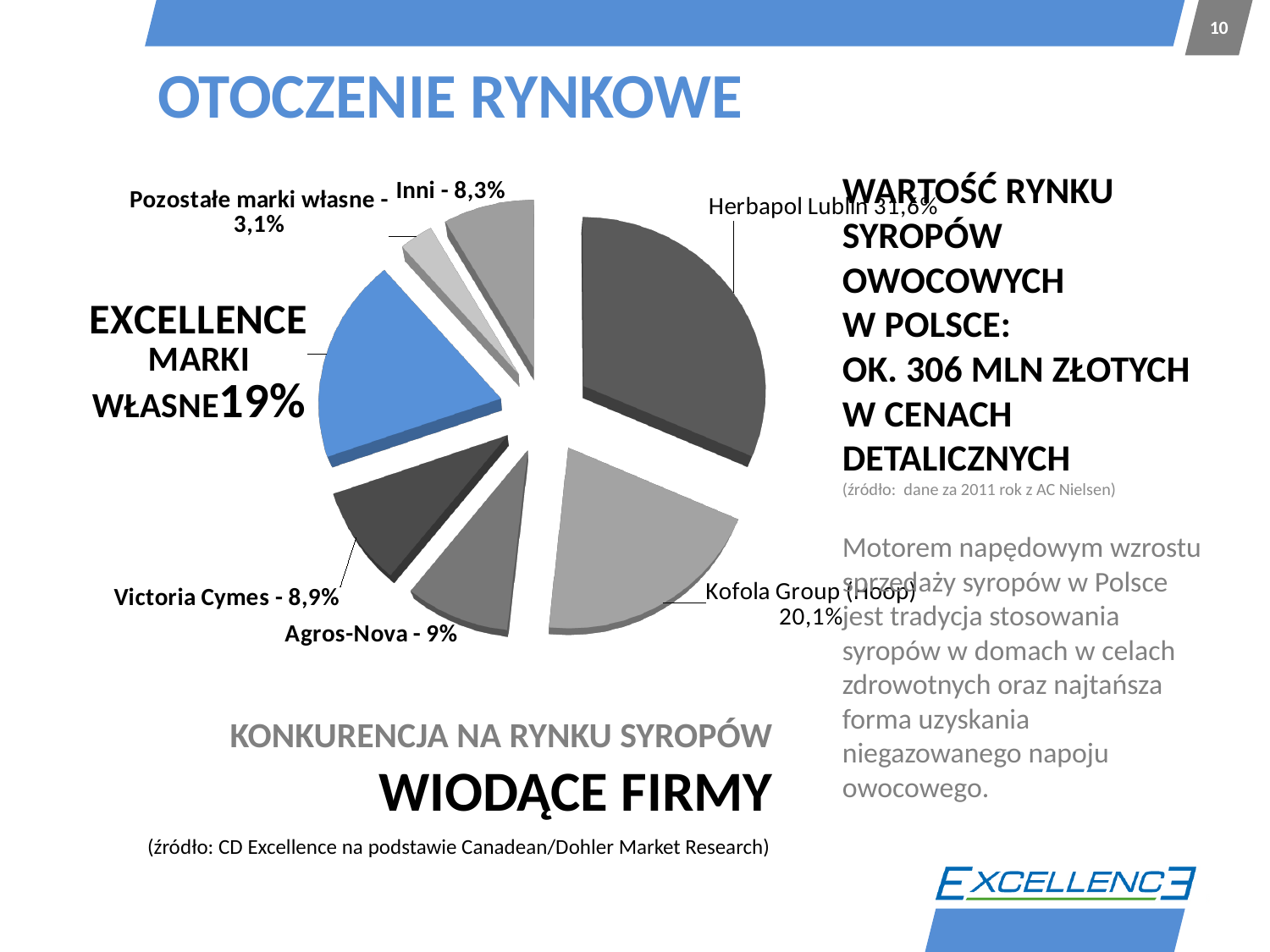
Which category has the smallest slice of the pie chart? Pozostałe marki własne What share is shown for Excellence Marki Własne in the pie chart? 19% What share of the syrup market does Kofola Group (Hoop) hold according to the pie chart? 20,1% What is the title of the pie chart? KONKURENCJA NA RYNKU SYROPÓW WIODĄCE FIRMY What share is shown for Inni in the pie chart? 8,3% How many slices does the pie chart have? 7 Which company has the largest slice of the pie chart? Herbapol Lublin What share is shown for Agros-Nova in the pie chart? 9% What type of chart is shown on the slide? pie chart Which has a larger share in the pie chart, Kofola Group (Hoop) or Excellence Marki Własne? Kofola Group (Hoop) What share is shown for Victoria Cymes in the pie chart? 8,9% What is the difference between the shares of Agros-Nova and Victoria Cymes in the pie chart? 0,1%